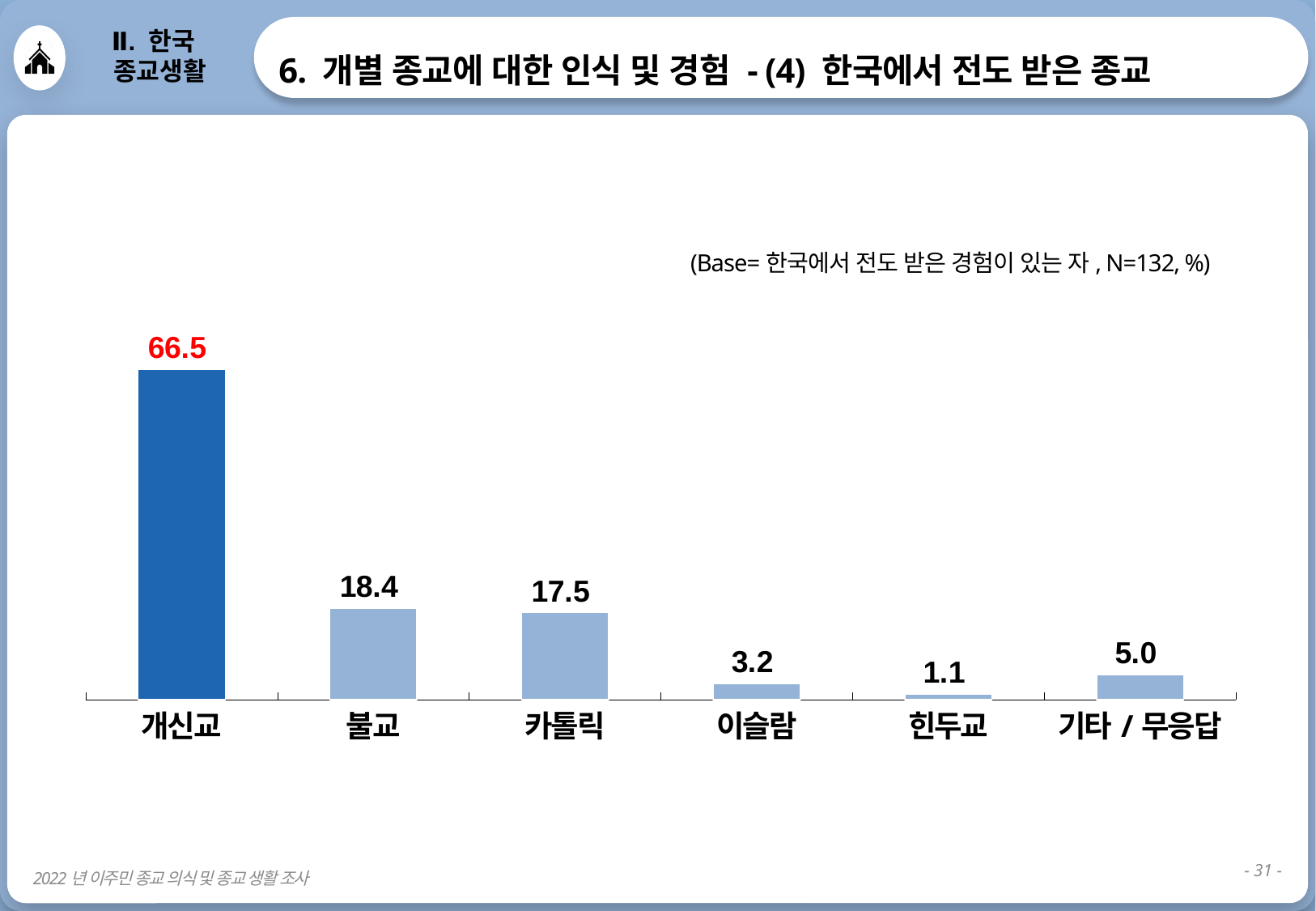
What is the difference between the values for 불교 and 카톨릭? 0.9 What kind of chart is shown on the slide? bar chart What is the value for 힌두교? 1.1 How many categories are shown on the chart? 6 What is the value for 기타 / 무응답? 5.0 Which is larger, the value for 이슬람 or the value for 기타 / 무응답? 기타 / 무응답 What is the sample size (N) stated in the base note on the slide? 132 Which category has the highest value? 개신교 What is the value for 개신교? 66.5 What is the value for 불교? 18.4 What is the value for 카톨릭? 17.5 Which category has the lowest value? 힌두교